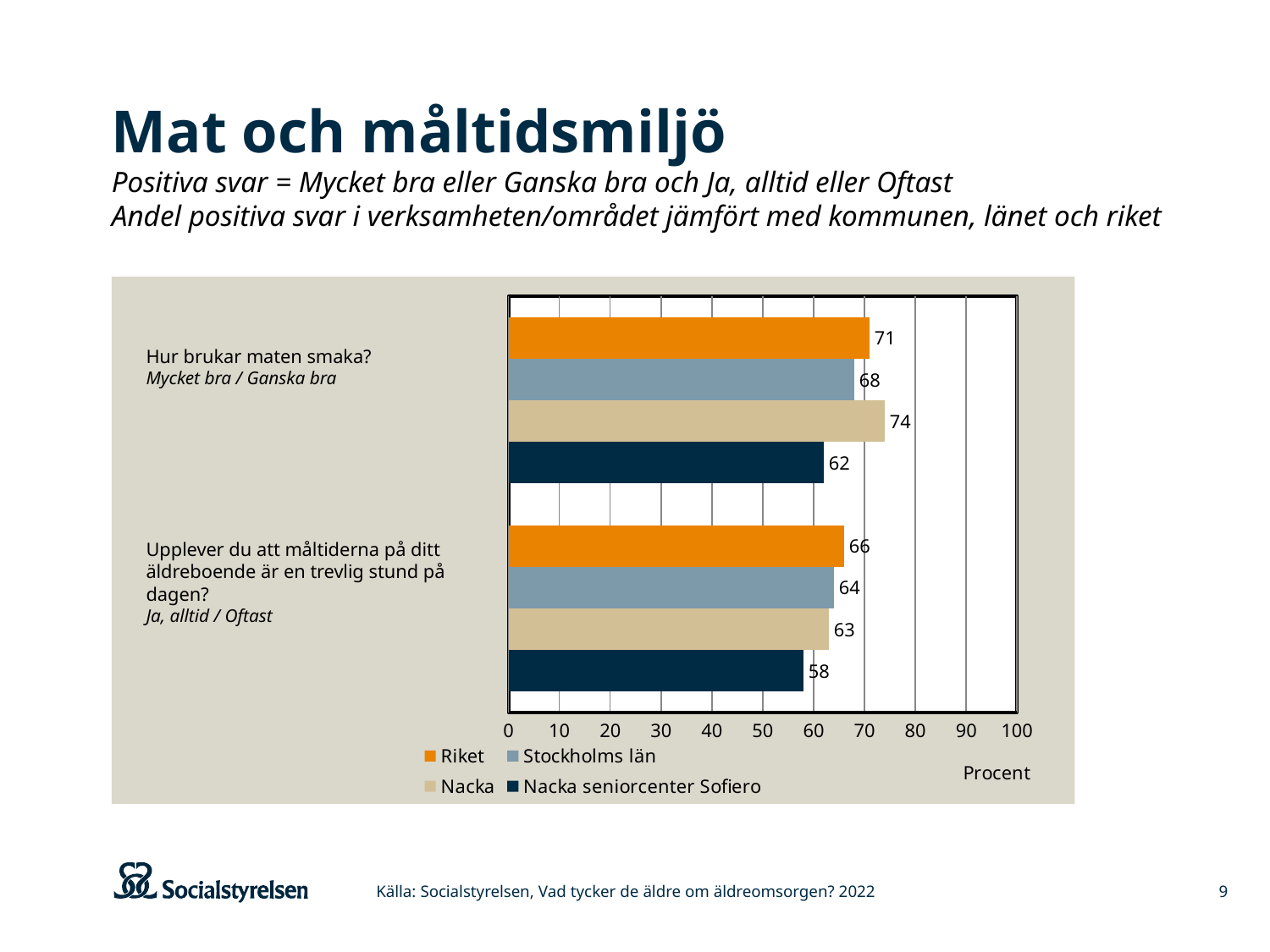
Which is larger for the question 'Upplever du att måltiderna på ditt äldreboende är en trevlig stund på dagen?': Riket or Stockholms län? Riket What is the value for Nacka seniorcenter Sofiero for the question 'Upplever du att måltiderna på ditt äldreboende är en trevlig stund på dagen?' 58 How many questions (categories) are shown on the chart? 2 Which series has the highest value for the question 'Hur brukar maten smaka?' Nacka What kind of chart is shown on the slide? Bar chart What is the value for Nacka for the question 'Upplever du att måltiderna på ditt äldreboende är en trevlig stund på dagen?' 63 What is the value for Riket for the question 'Hur brukar maten smaka?' 71 Which series has the lowest value for the question 'Upplever du att måltiderna på ditt äldreboende är en trevlig stund på dagen?' Nacka seniorcenter Sofiero What is the label of the x axis? Procent What is the value for Stockholms län for the question 'Hur brukar maten smaka?' 68 What is the difference between the Nacka value and the Nacka seniorcenter Sofiero value for the question 'Hur brukar maten smaka?' 12 How many series does the legend list? 4